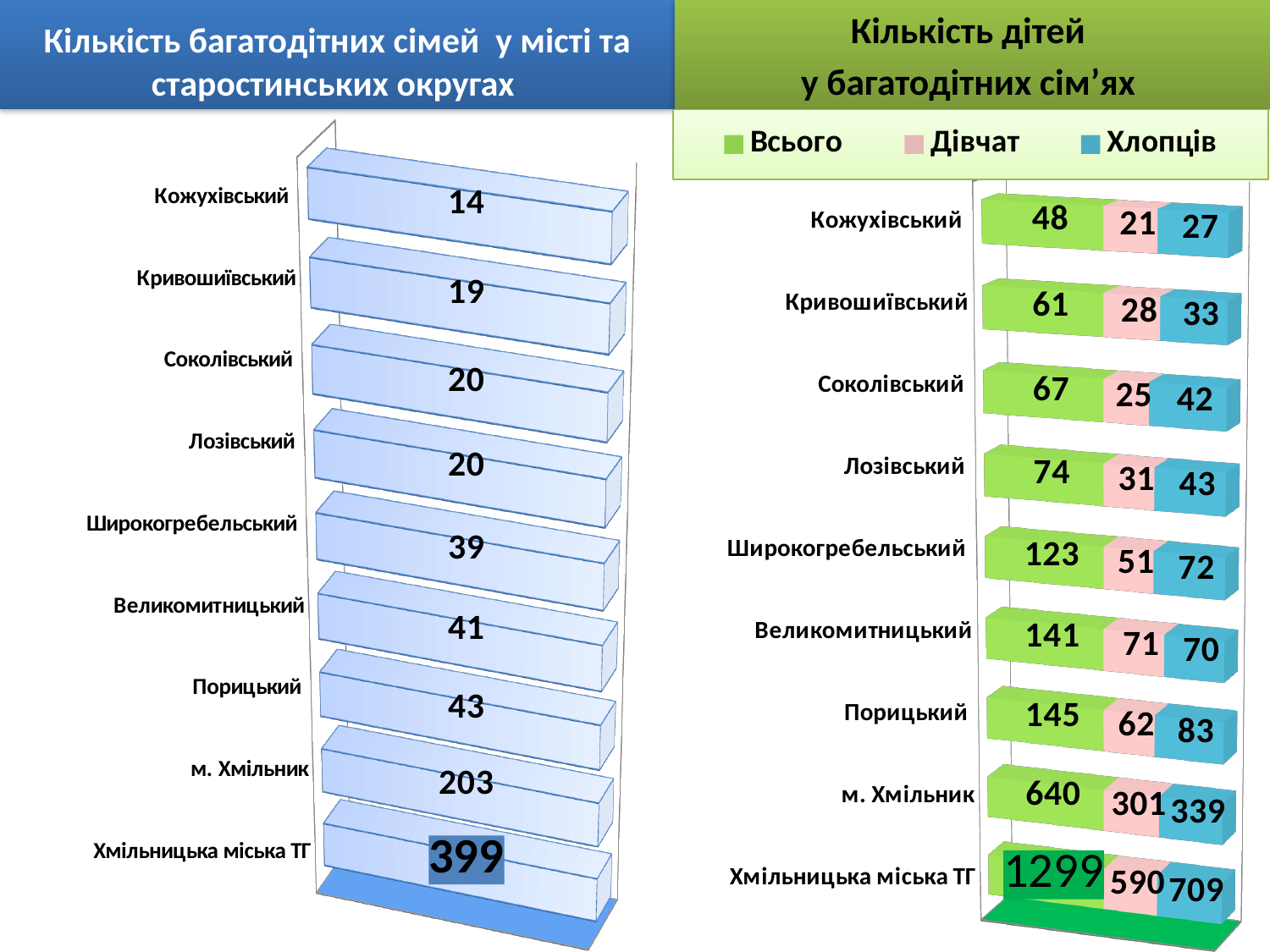
In the right chart 'Кількість дітей у багатодітних сім'ях', what is the Дівчат value for Лозівський? 31 In the right chart 'Кількість дітей у багатодітних сім'ях', what is the Хлопців value for м. Хмільник? 339 In the right chart 'Кількість дітей у багатодітних сім'ях', how many series does the legend list? 3 In the left chart 'Кількість багатодітних сімей у місті та старостинських округах', which category has the highest value? Хмільницька міська ТГ In the right chart 'Кількість дітей у багатодітних сім'ях', which is larger for Соколівський: Дівчат or Хлопців? Хлопців In the left chart 'Кількість багатодітних сімей у місті та старостинських округах', what is the value for Порицький? 43 In the right chart 'Кількість дітей у багатодітних сім'ях', what is the difference between the Хлопців and Дівчат values for Хмільницька міська ТГ? 119 In the left chart 'Кількість багатодітних сімей у місті та старостинських округах', which category has the lowest value? Кожухівський In the left chart 'Кількість багатодітних сімей у місті та старостинських округах', what is the value for м. Хмільник? 203 What kind of chart is the left chart 'Кількість багатодітних сімей у місті та старостинських округах'? Bar chart In the left chart 'Кількість багатодітних сімей у місті та старостинських округах', how many categories are shown? 9 In the left chart 'Кількість багатодітних сімей у місті та старостинських округах', what is the difference between the values for Широкогребельський and Кривошиївський? 20